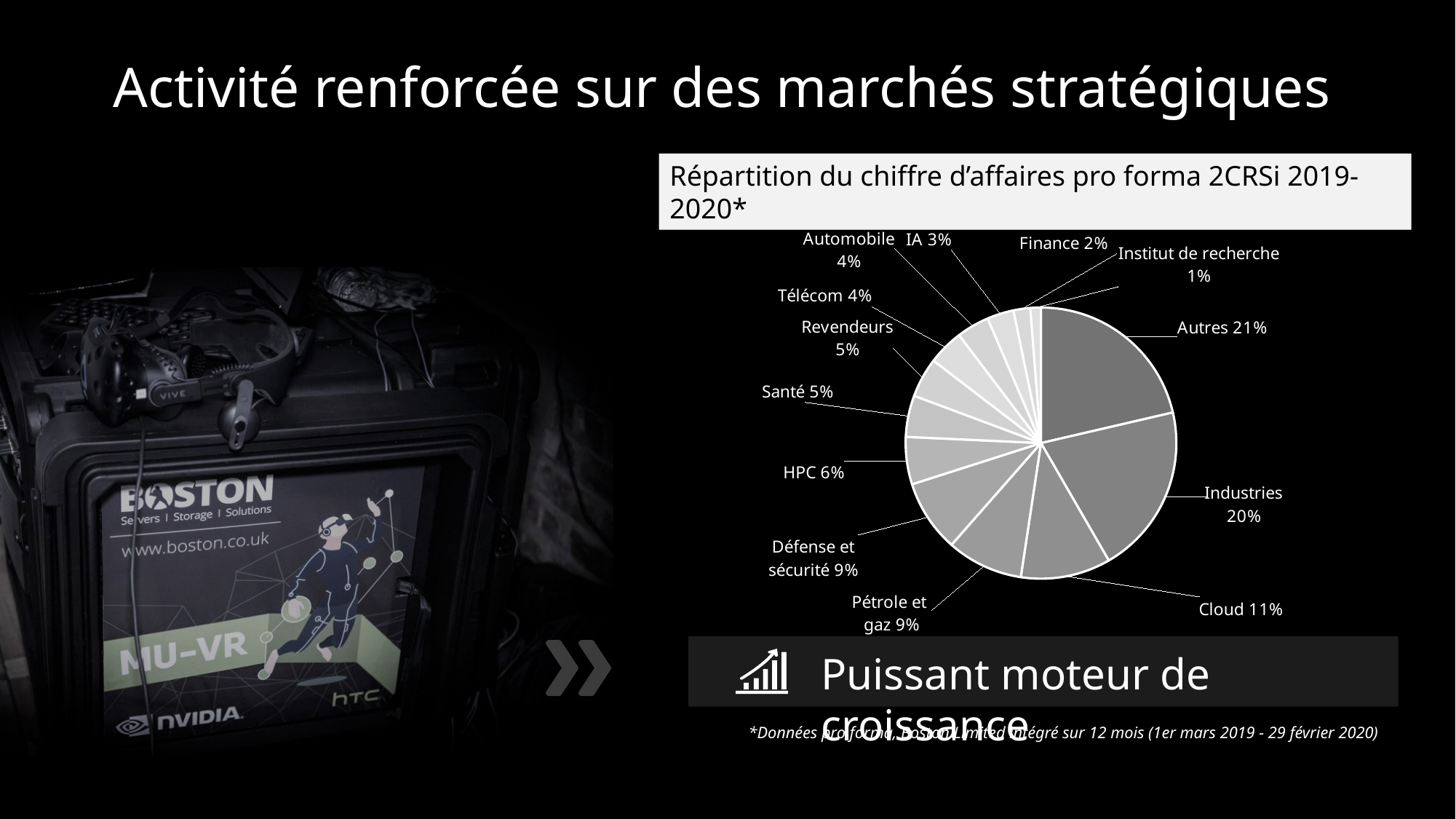
Which is larger, the share for Défense et sécurité or the share for HPC? Défense et sécurité Which category has the smallest share of the pie? Institut de recherche What is the difference in percentage points between Autres and Cloud? 10 What share of revenue does Cloud represent? 11% Which category has the largest share of the pie? Autres What kind of chart is shown on the slide? pie chart What share of revenue does HPC represent? 6% How many categories are shown in the pie chart? 13 What is the title of the chart? Répartition du chiffre d'affaires pro forma 2CRSi 2019-2020* What is the combined share of Télécom and Automobile? 8% What share of revenue does Industries represent? 20% What share of revenue does Institut de recherche represent? 1%